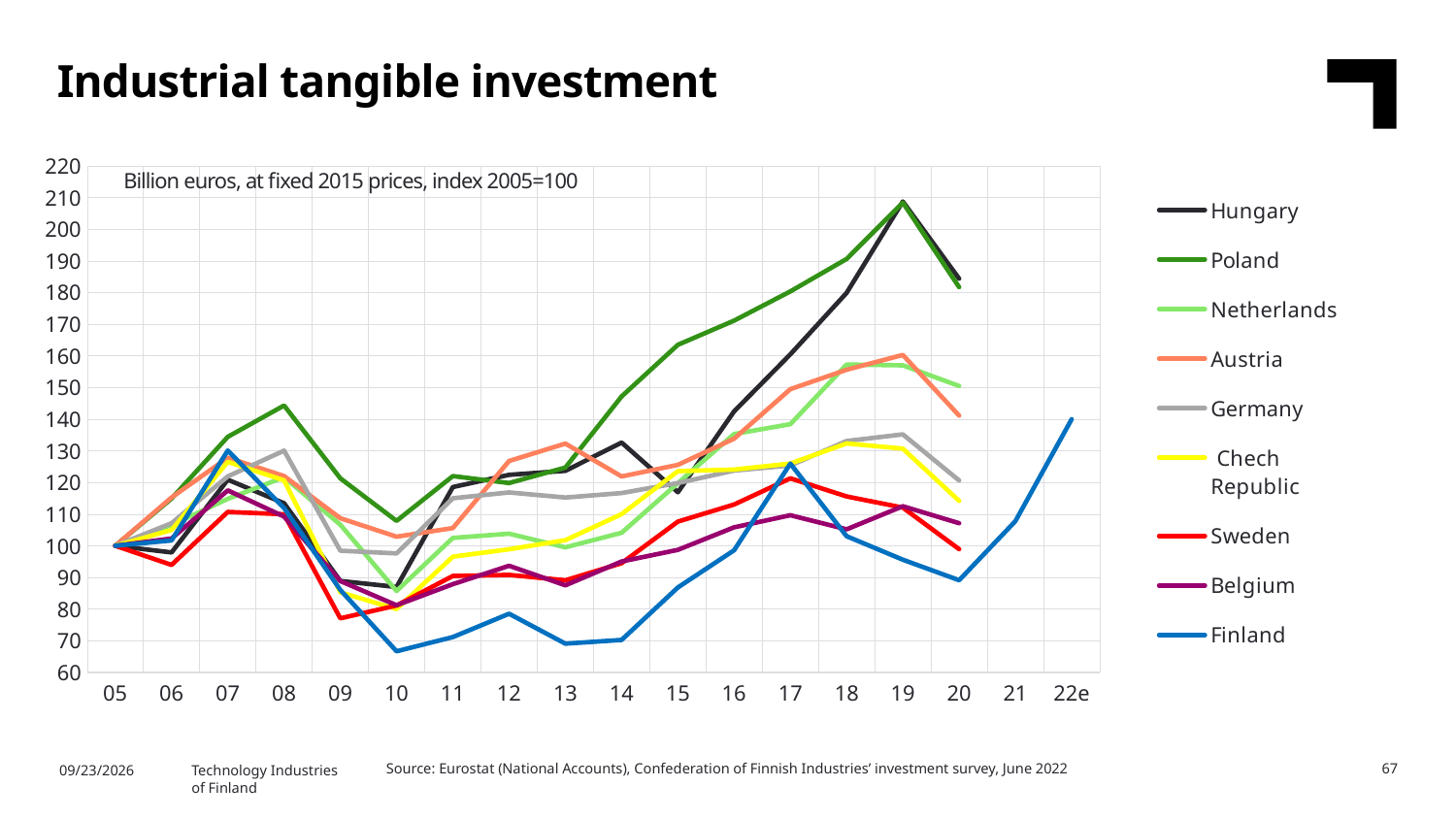
How many year labels are shown on the x axis? 18 Which series has the lowest value in 10? Finland Is the value for Poland in 19 greater or less than 200? greater Does the Finland line rise or fall from 20 to 22e? rise How many series does the legend list? 9 Which series is the only one plotted through 21 and 22e? Finland Which series has the lowest value in 20? Finland What type of chart is shown on the slide? line chart Which is larger in 20, Austria or Germany? Austria What is the value for Hungary in 05? 100 Is the value for Finland in 10 greater or less than 80? less Which series has the highest value in 08? Poland